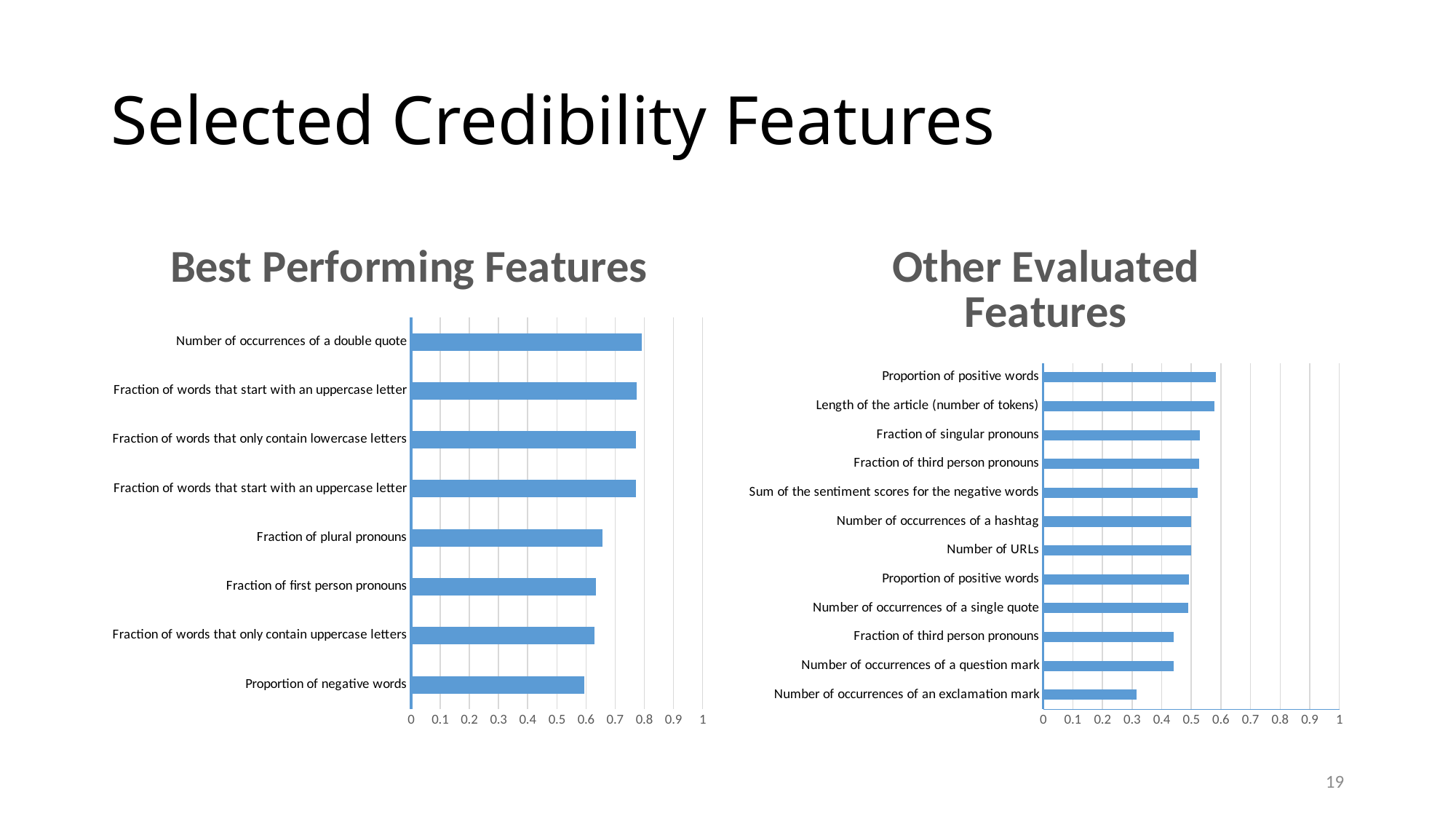
In the Best Performing Features chart, which is larger: Number of occurrences of a double quote or Proportion of negative words? Number of occurrences of a double quote In the Best Performing Features chart, which feature has the lowest value? Proportion of negative words How many features are plotted in the Best Performing Features chart? 8 In the Other Evaluated Features chart, is the value for Number of occurrences of a question mark greater or less than 0.5? less In the Other Evaluated Features chart, which is larger: Number of occurrences of a question mark or Number of occurrences of an exclamation mark? Number of occurrences of a question mark In the Best Performing Features chart, is the value for Number of occurrences of a double quote greater or less than 0.7? greater In the Other Evaluated Features chart, which feature has the lowest value? Number of occurrences of an exclamation mark In the Other Evaluated Features chart, is the value for Number of occurrences of an exclamation mark greater or less than 0.4? less What kind of chart is the Best Performing Features chart? bar chart How many features are plotted in the Other Evaluated Features chart? 12